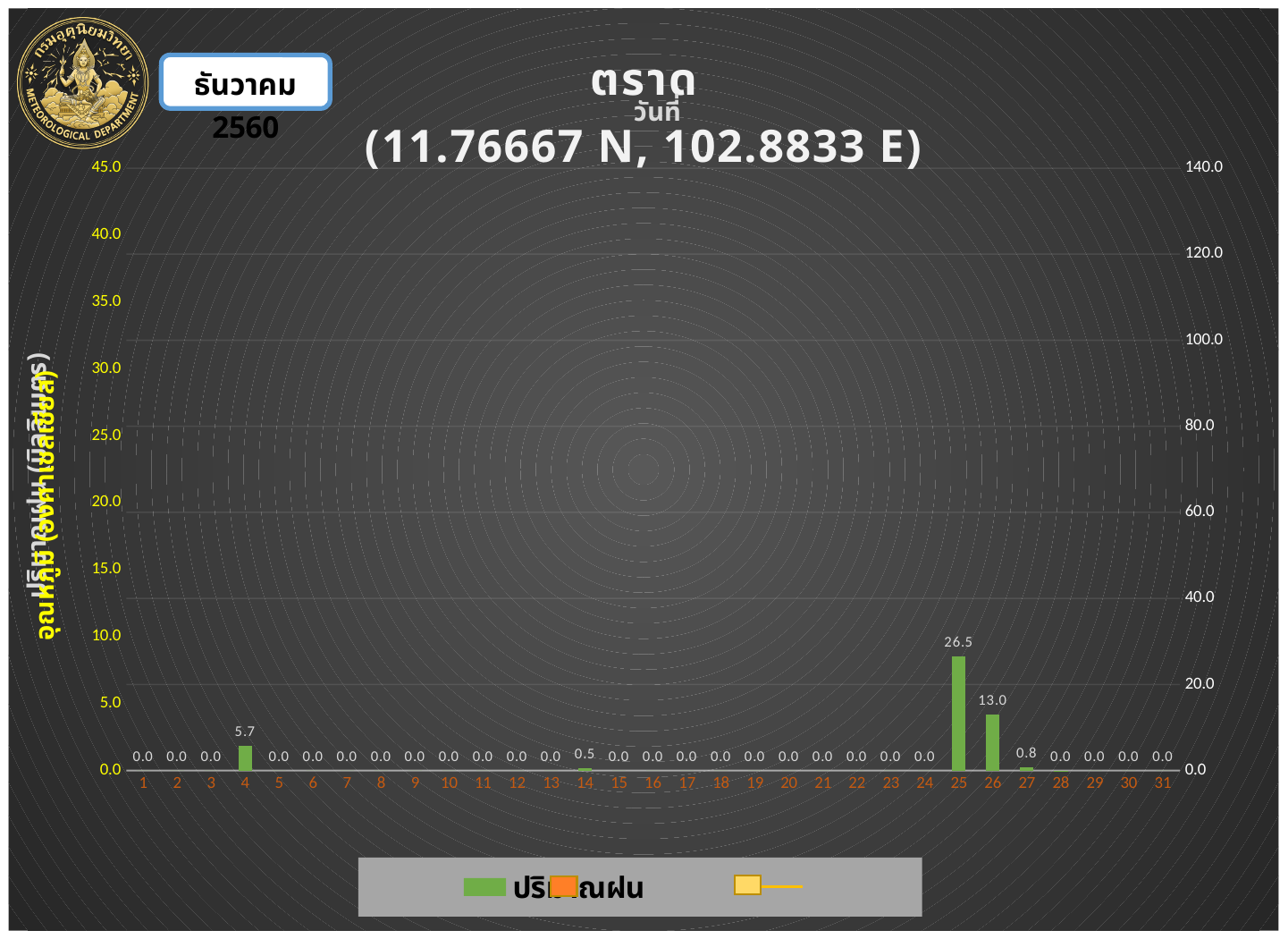
What is the difference between the rainfall values for day 25 and day 26? 13.5 What is the rainfall value shown for day 14? 0.5 What is the rainfall value shown for day 25? 26.5 What is the rainfall value shown for day 4? 5.7 How many days are shown on the x axis? 31 What is the rainfall value shown for day 27? 0.8 What is the difference between the rainfall values for day 26 and day 4? 7.3 Is the rainfall value for day 25 greater or less than 20.0 on the right axis? greater Which day has the larger rainfall value, day 4 or day 26? 26 Which day has the highest rainfall value? 25 What is the rainfall value shown for day 26? 13.0 What kind of chart is shown on the slide? bar chart